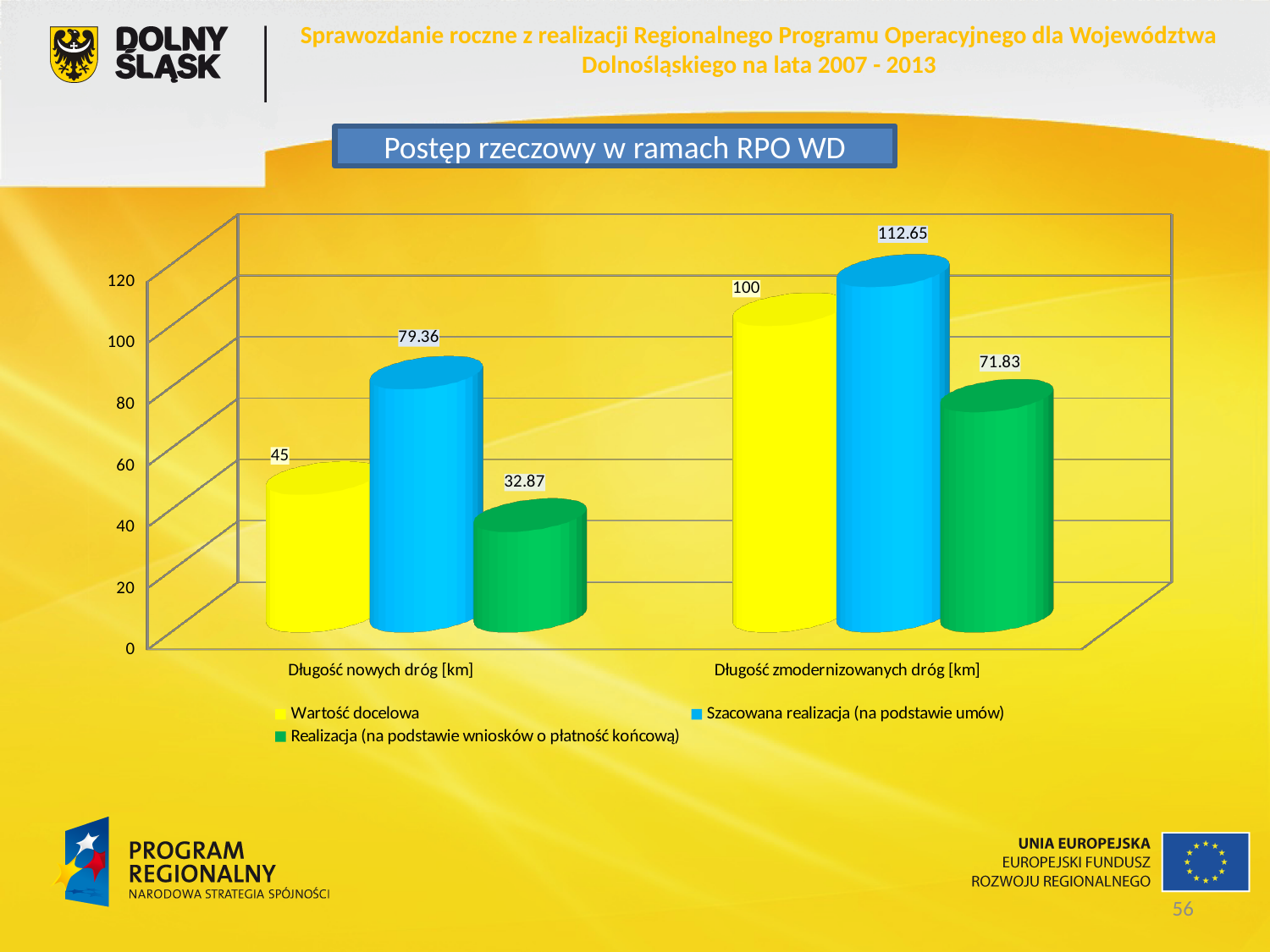
What is the value of 'Realizacja (na podstawie wniosków o płatność końcową)' for 'Długość zmodernizowanych dróg [km]'? 71.83 What is the difference between 'Szacowana realizacja (na podstawie umów)' and 'Wartość docelowa' for 'Długość nowych dróg [km]'? 34.36 What is the difference between 'Wartość docelowa' and 'Realizacja (na podstawie wniosków o płatność końcową)' for 'Długość zmodernizowanych dróg [km]'? 28.17 What is the value of 'Wartość docelowa' for 'Długość nowych dróg [km]'? 45 What type of chart is shown on the slide? Bar chart Which series has the lowest value for 'Długość nowych dróg [km]'? Realizacja (na podstawie wniosków o płatność końcową) Which series has the highest value for 'Długość zmodernizowanych dróg [km]'? Szacowana realizacja (na podstawie umów) How many categories are shown on the x axis? 2 What is the value of 'Realizacja (na podstawie wniosków o płatność końcową)' for 'Długość nowych dróg [km]'? 32.87 Which is larger: 'Szacowana realizacja (na podstawie umów)' for 'Długość nowych dróg [km]' or 'Realizacja (na podstawie wniosków o płatność końcową)' for 'Długość zmodernizowanych dróg [km]'? Szacowana realizacja (na podstawie umów) for Długość nowych dróg [km] How many series does the legend list? 3 What is the value of 'Szacowana realizacja (na podstawie umów)' for 'Długość zmodernizowanych dróg [km]'? 112.65